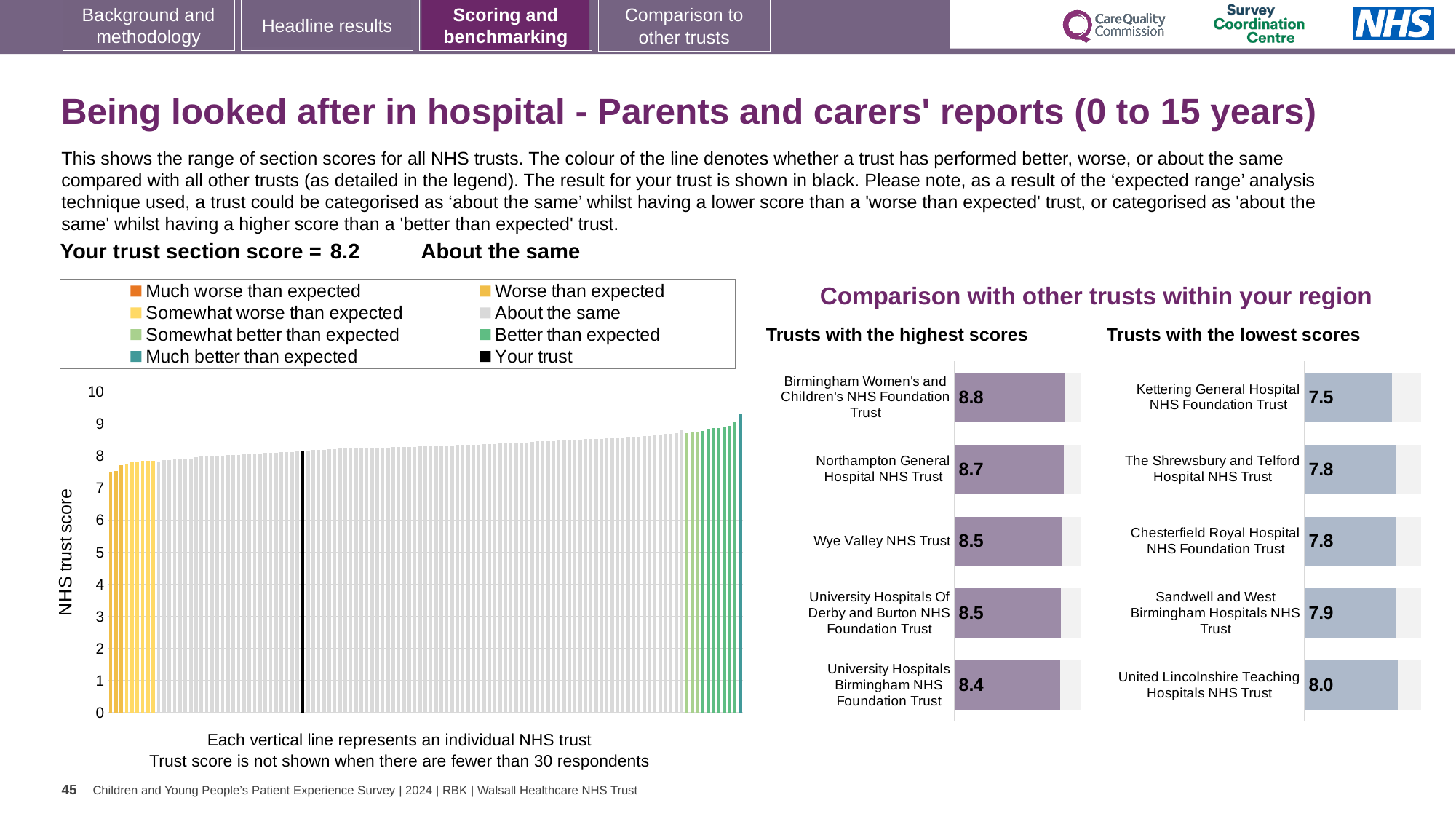
In the 'Trusts with the lowest scores' chart, what is the difference between the scores of United Lincolnshire Teaching Hospitals NHS Trust and Kettering General Hospital NHS Foundation Trust? 0.5 In the main NHS trust score chart on the left, do the trust scores rise or fall from left to right? Rise In the 'Trusts with the highest scores' chart, which has the higher score: Northampton General Hospital NHS Trust or Wye Valley NHS Trust? Northampton General Hospital NHS Trust In the 'Trusts with the highest scores' chart, which trust has the highest score? Birmingham Women's and Children's NHS Foundation Trust How many entries does the legend of the main NHS trust score chart on the left list? 8 In the 'Trusts with the lowest scores' chart, what is the score for United Lincolnshire Teaching Hospitals NHS Trust? 8.0 In the 'Trusts with the lowest scores' chart, which trust has the lowest score? Kettering General Hospital NHS Foundation Trust What kind of chart is the 'Trusts with the lowest scores' chart? Bar chart In the 'Trusts with the highest scores' chart, what is the difference between the scores of Birmingham Women's and Children's NHS Foundation Trust and University Hospitals Birmingham NHS Foundation Trust? 0.4 In the 'Trusts with the highest scores' chart, what is the score for Birmingham Women's and Children's NHS Foundation Trust? 8.8 How many trusts are shown in the 'Trusts with the highest scores' chart? 5 In the 'Trusts with the lowest scores' chart, what is the score for Kettering General Hospital NHS Foundation Trust? 7.5